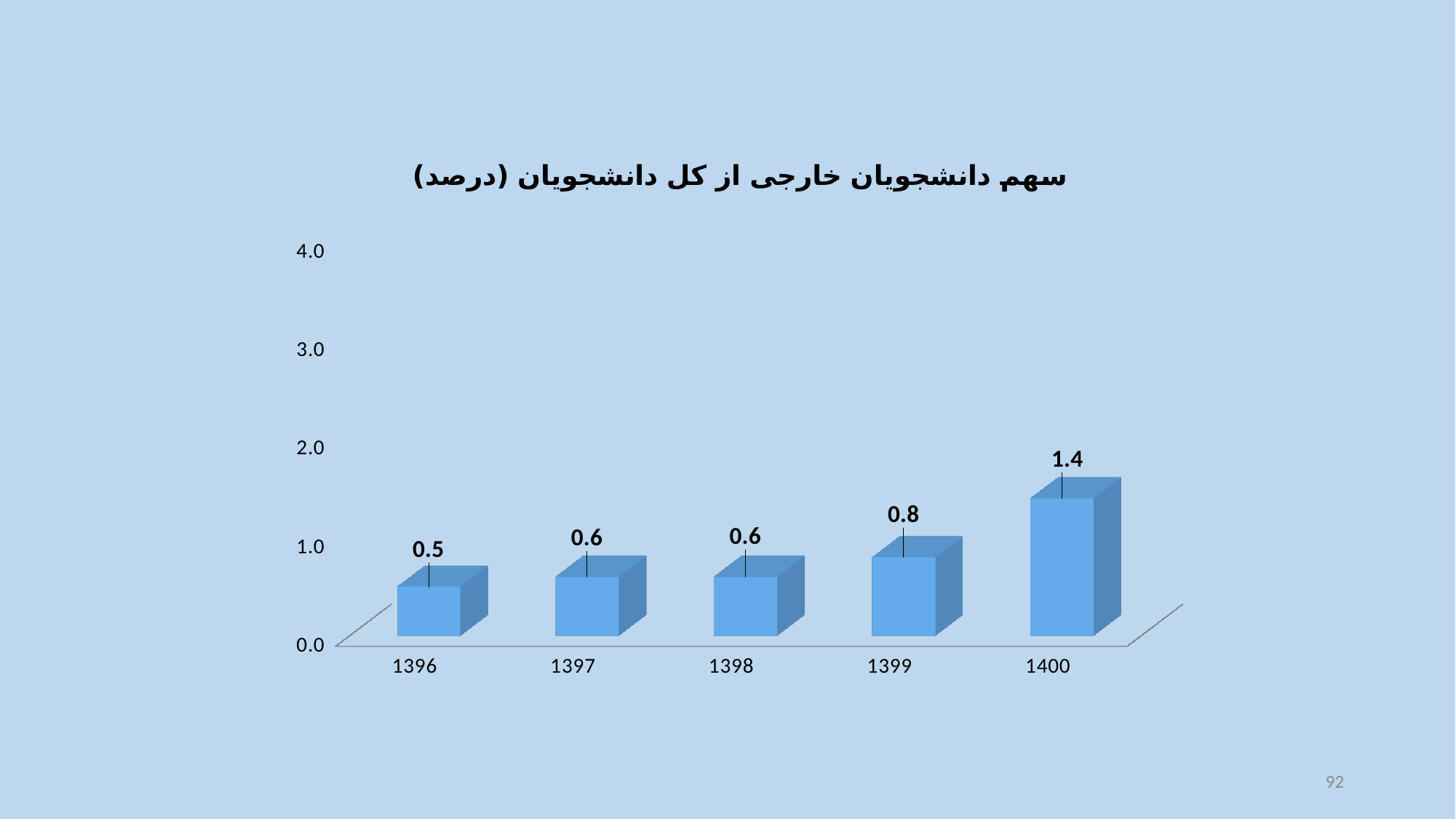
What is the value for 1400? 1.4 What kind of chart is shown on the slide? bar chart Which is larger, the value for 1399 or the value for 1397? 1399 What is the difference between the values for 1400 and 1399? 0.6 Do the values generally rise or fall from 1396 to 1400? rise Is the value for 1400 greater or less than 1.0? greater What is the value for 1399? 0.8 Which year has the lowest value? 1396 Which year has the highest value? 1400 What is the difference between the values for 1399 and 1396? 0.3 How many years are shown on the x axis? 5 What is the value for 1396? 0.5